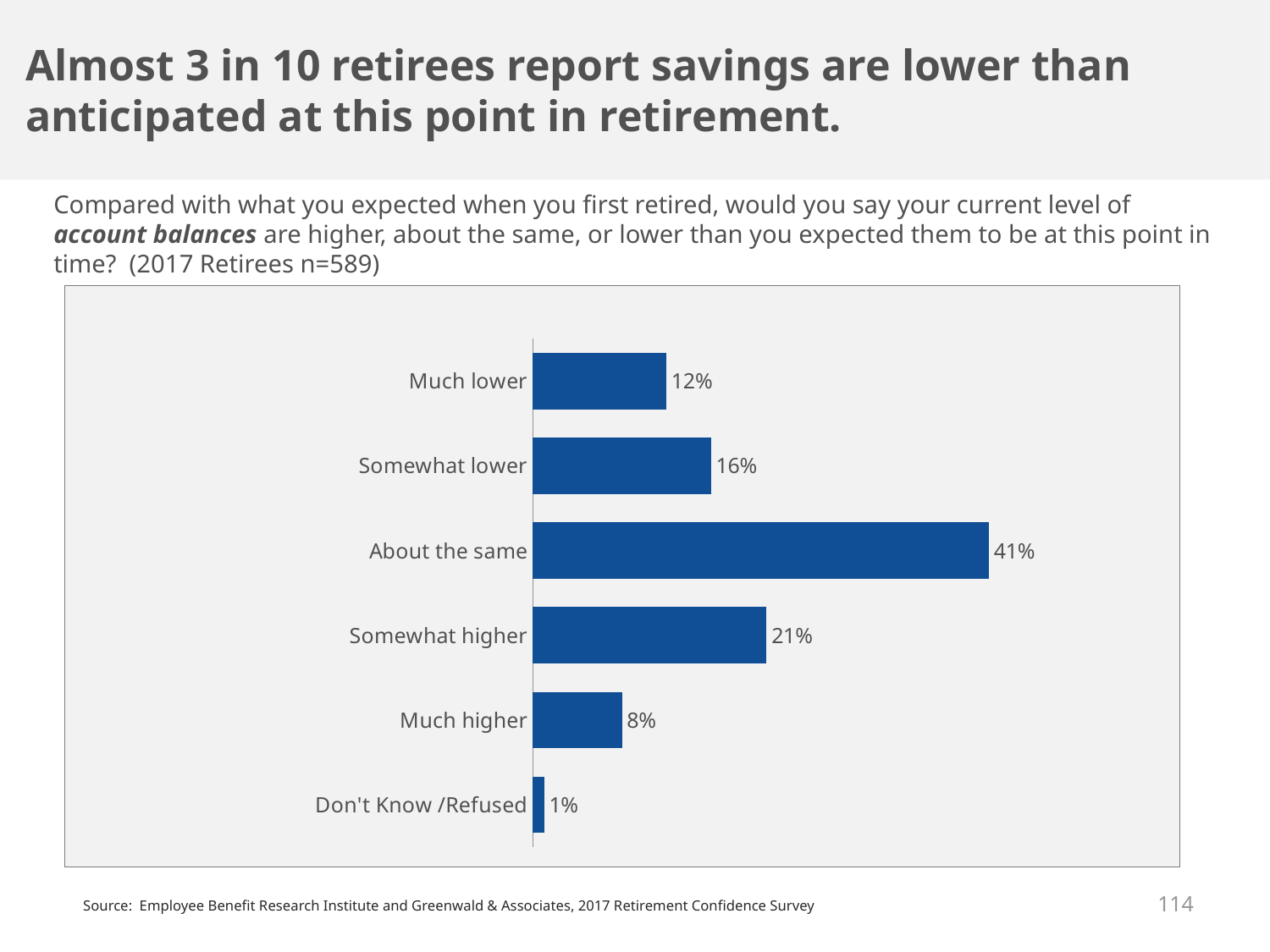
Which is larger, the percentage for Somewhat higher or the percentage for Somewhat lower? Somewhat higher Which response category has the lowest percentage? Don't Know /Refused Which response category has the highest percentage? About the same What is the difference in percentage points between About the same and Somewhat higher? 20 What kind of chart is shown on the slide? Bar chart What percentage of retirees answered Somewhat higher? 21% What percentage of retirees said their account balances are about the same as expected? 41% What percentage of retirees answered Don't Know /Refused? 1% What is the difference in percentage points between Somewhat lower and Much lower? 4 What is the combined percentage of retirees who said Much lower or Somewhat lower? 28% What percentage of retirees said their account balances are much lower than expected? 12% How many response categories are shown in the chart? 6